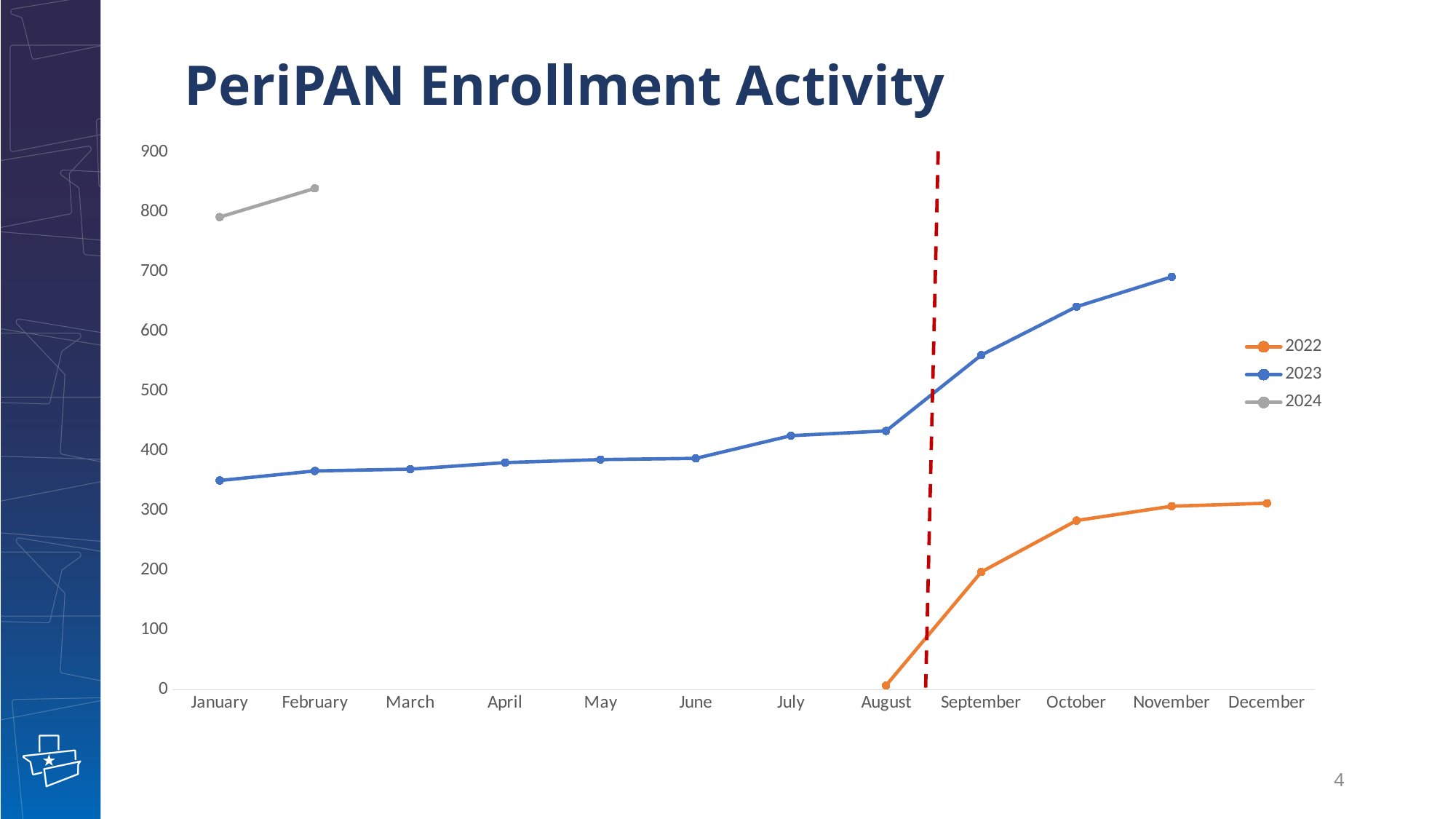
Does the 2022 series rise or fall from August to December? rise How many months are shown along the x axis? 12 How many series does the legend list? 3 What is the title of the chart? PeriPAN Enrollment Activity What kind of chart is shown on the slide? line chart Is the 2023 value for November greater or less than 600? greater Is the 2024 value for February greater or less than 800? greater Is the 2022 value for December greater or less than 400? less In October, which series has the larger value, 2022 or 2023? 2023 In which month is the 2023 series at its lowest value? January In which month does the 2023 series reach its highest value? November